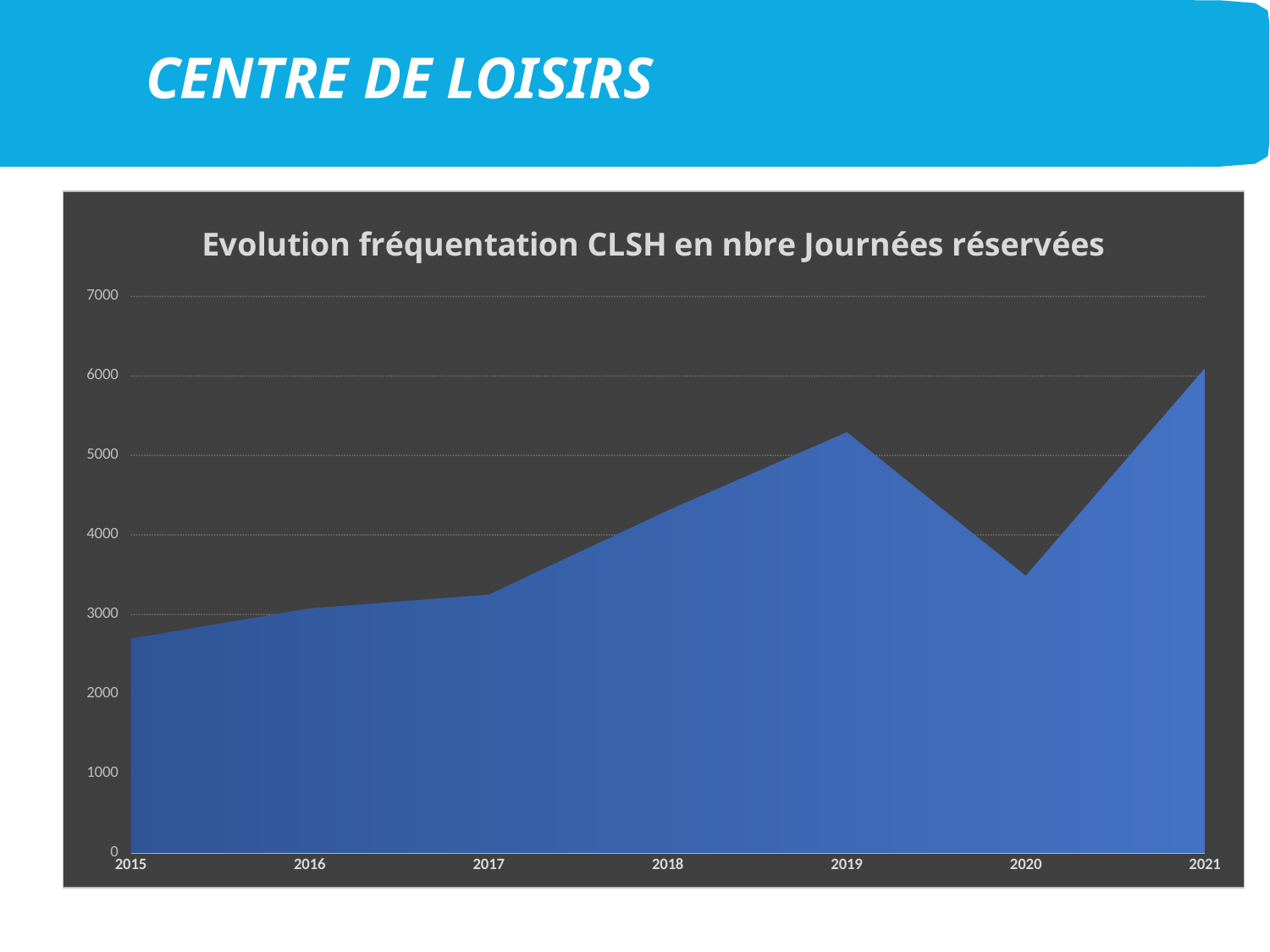
What kind of chart is shown on the slide? area chart Which year has the highest value in the chart? 2021 What is the title of the chart? Evolution fréquentation CLSH en nbre Journées réservées Which year has the larger value, 2017 or 2018? 2018 Which year has the lowest value in the chart? 2015 Is the value for 2021 greater or less than 6000? greater Which year has the larger value, 2019 or 2020? 2019 Does the value rise or fall from 2019 to 2020? fall Is the value for 2015 greater or less than 3000? less How many years are shown on the x axis of the chart? 7 Is the value for 2019 greater or less than 5000? greater